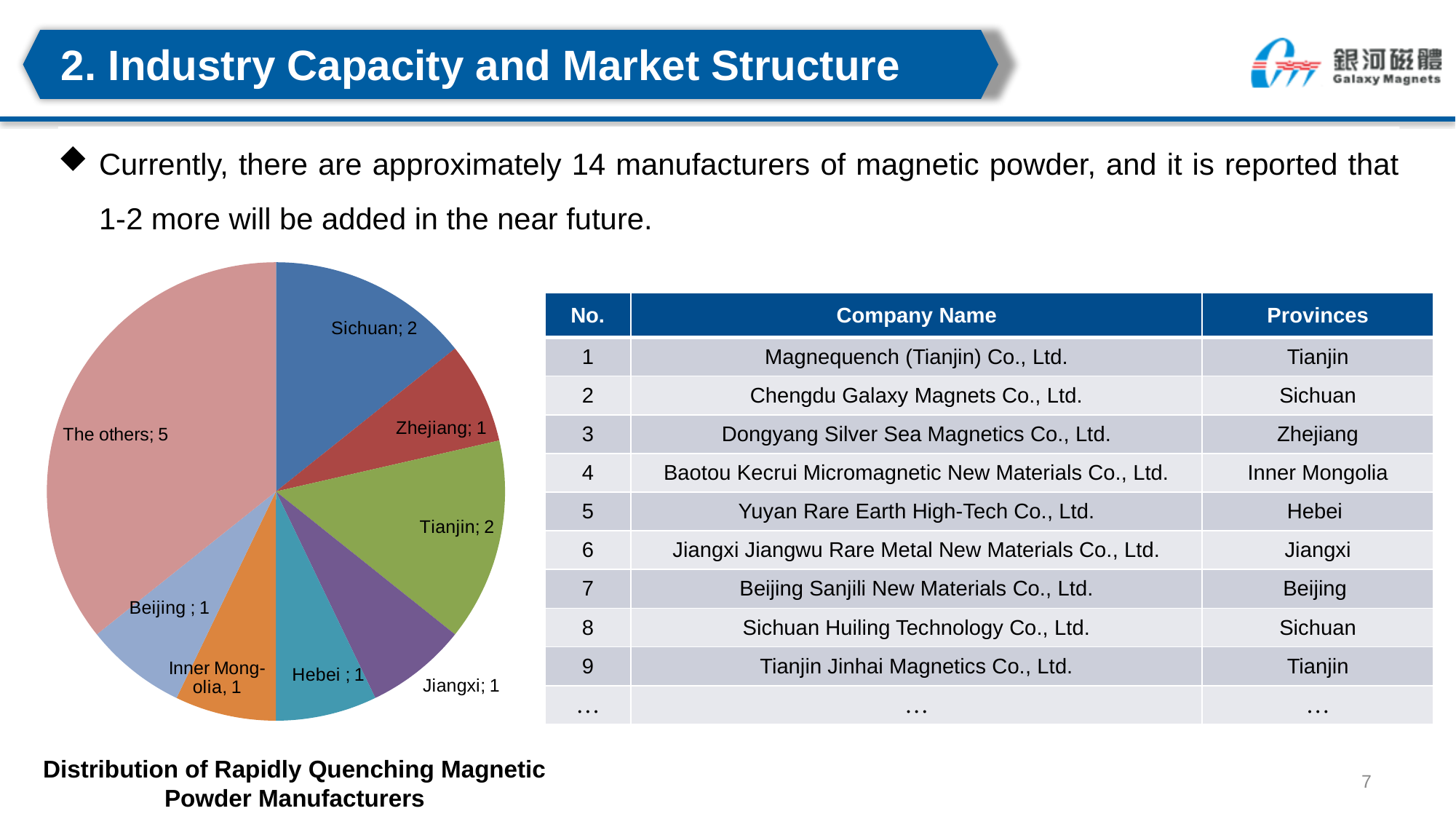
Which is larger in the pie chart, Sichuan or Zhejiang? Sichuan What is the total of all slice values in the pie chart? 14 What is the difference between the values for The others and Tianjin in the pie chart? 3 What is the value for Tianjin in the pie chart? 2 What is the value for Sichuan in the pie chart? 2 What is the value for Inner Mongolia in the pie chart? 1 What is the title of the pie chart? Distribution of Rapidly Quenching Magnetic Powder Manufacturers What is the value for The others in the pie chart? 5 How many slices does the pie chart have? 8 What fraction of the pie chart's total does The others slice represent? 5 of 14 Which slice of the pie chart has the largest value? The others What kind of chart is shown on the slide? pie chart